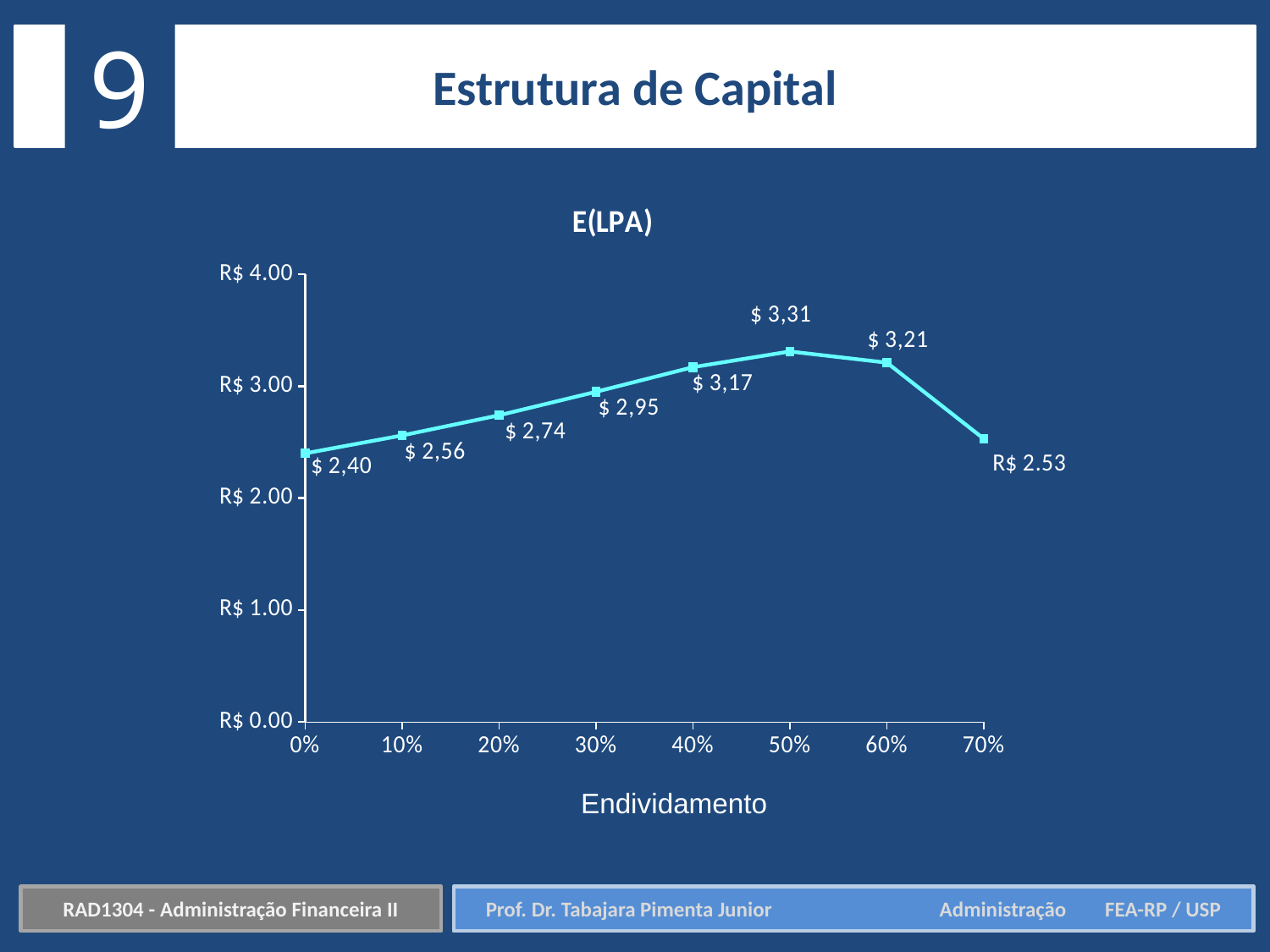
What is the value of E(LPA) at 50% Endividamento? $ 3,31 How many data points are plotted on the chart? 8 Is the value of E(LPA) at 20% Endividamento greater or less than R$ 3.00? less What is the label of the x axis? Endividamento What kind of chart is shown on the slide? line chart What is the difference between E(LPA) at 50% and at 60% Endividamento? 0,10 What is the value of E(LPA) at 70% Endividamento? R$ 2.53 What is the value of E(LPA) at 0% Endividamento? $ 2,40 What is the value of E(LPA) at 30% Endividamento? $ 2,95 Which is larger, E(LPA) at 40% or at 60% Endividamento? 60% At which Endividamento level is E(LPA) highest? 50% At which Endividamento level is E(LPA) lowest? 0%